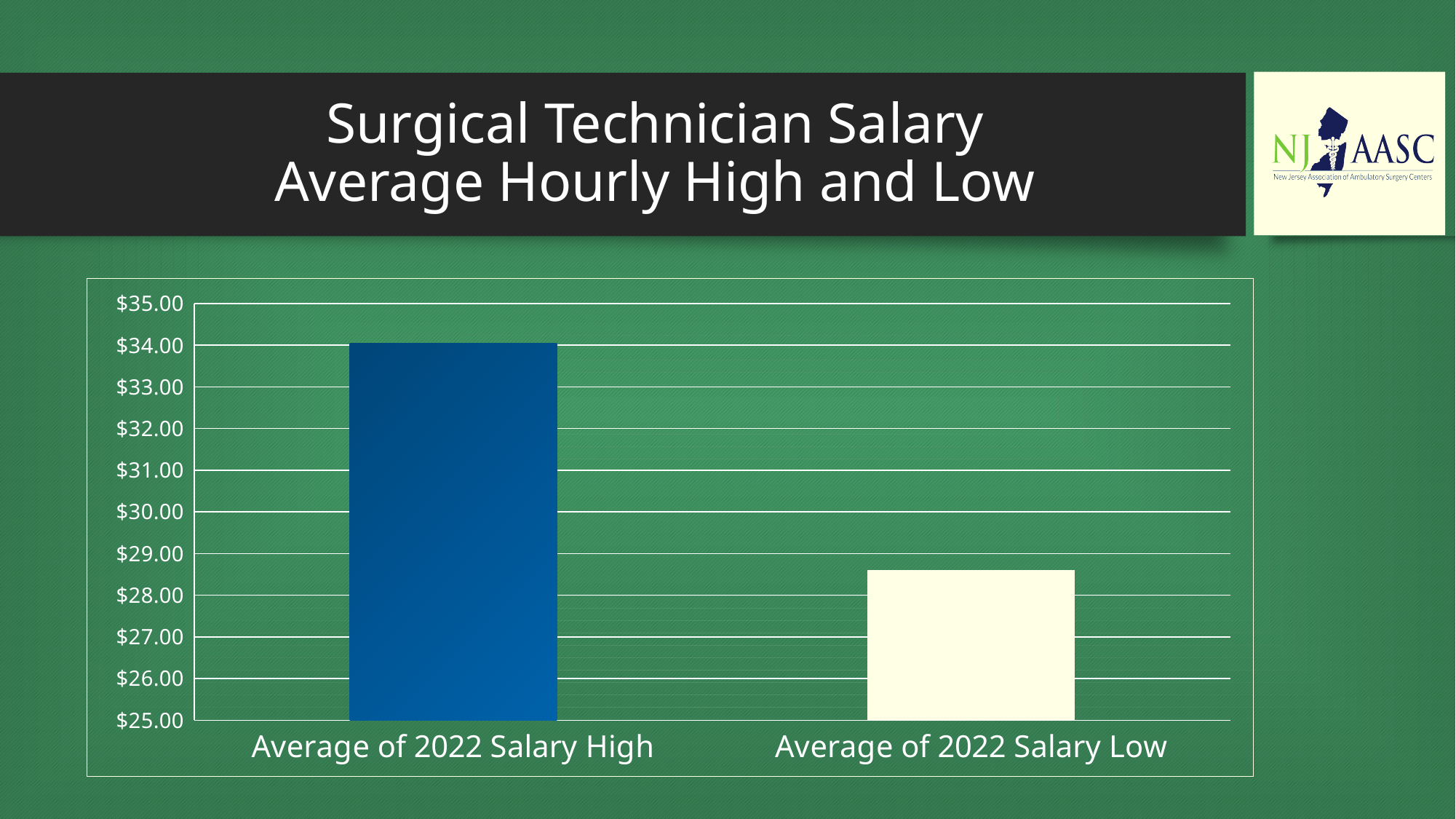
Is the value for Average of 2022 Salary High greater or less than $30.00? greater Is the value for Average of 2022 Salary Low greater or less than $28.00? greater What is the title shown above the chart? Surgical Technician Salary Average Hourly High and Low Is the value for Average of 2022 Salary Low greater or less than $29.00? less Which category has the highest value in the chart? Average of 2022 Salary High What kind of chart is shown on the slide? bar chart Which category has the lowest value in the chart? Average of 2022 Salary Low Which category has the higher value, Average of 2022 Salary High or Average of 2022 Salary Low? Average of 2022 Salary High How many bars are plotted in the chart? 2 What is the lowest value shown on the vertical axis? $25.00